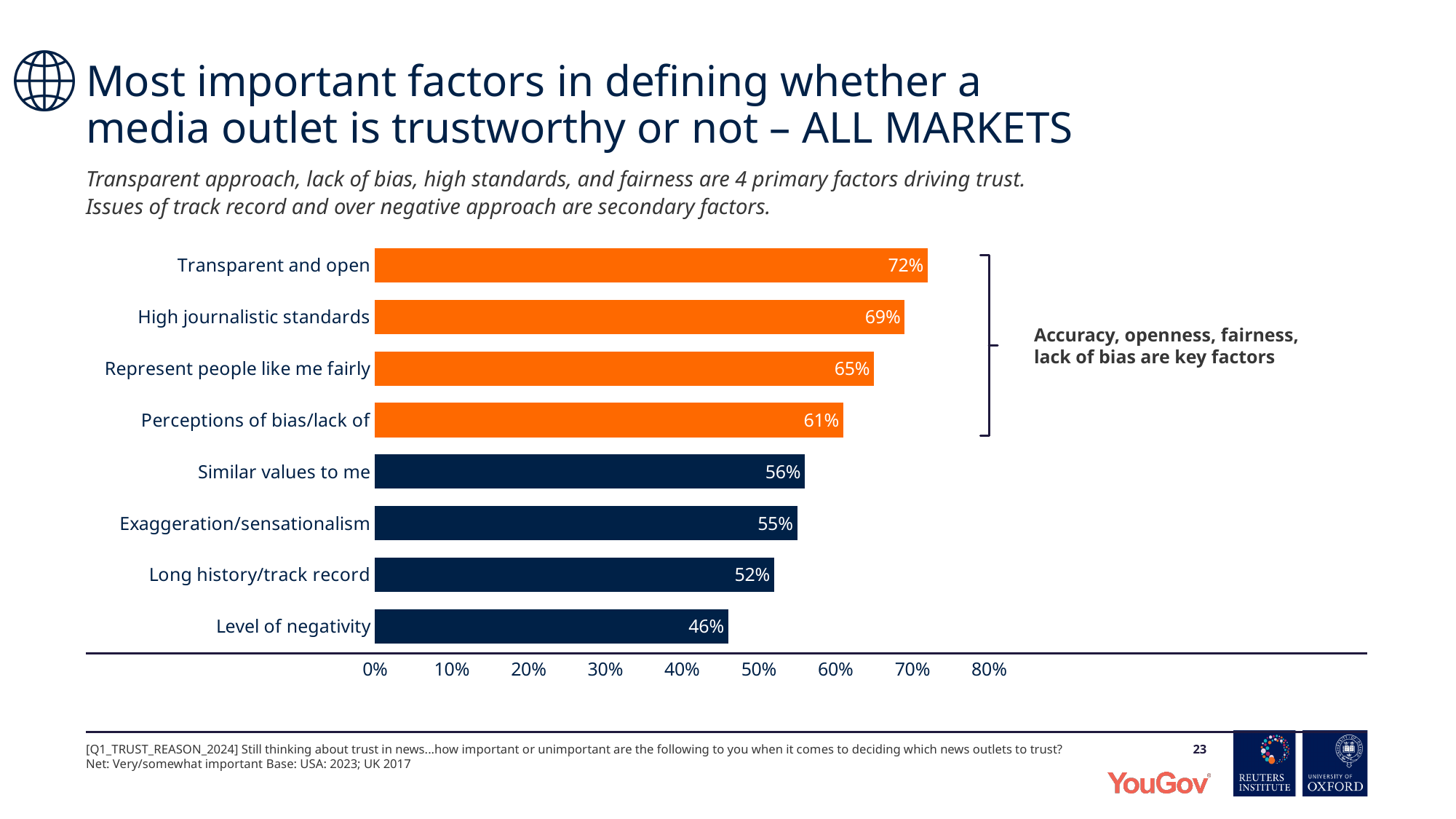
Is the value for Level of negativity greater or less than 50%? less What kind of chart is shown on the slide? bar chart What is the difference between the values for Represent people like me fairly and Perceptions of bias/lack of? 4% Which category has the highest value? Transparent and open Which category has the lowest value? Level of negativity How many categories are shown in the chart? 8 Which is larger, the value for Exaggeration/sensationalism or the value for Long history/track record? Exaggeration/sensationalism What is the value for Transparent and open? 72% What is the value for Long history/track record? 52% How many bars are coloured orange? 4 What is the value for Similar values to me? 56% What is the difference between the values for High journalistic standards and Level of negativity? 23%